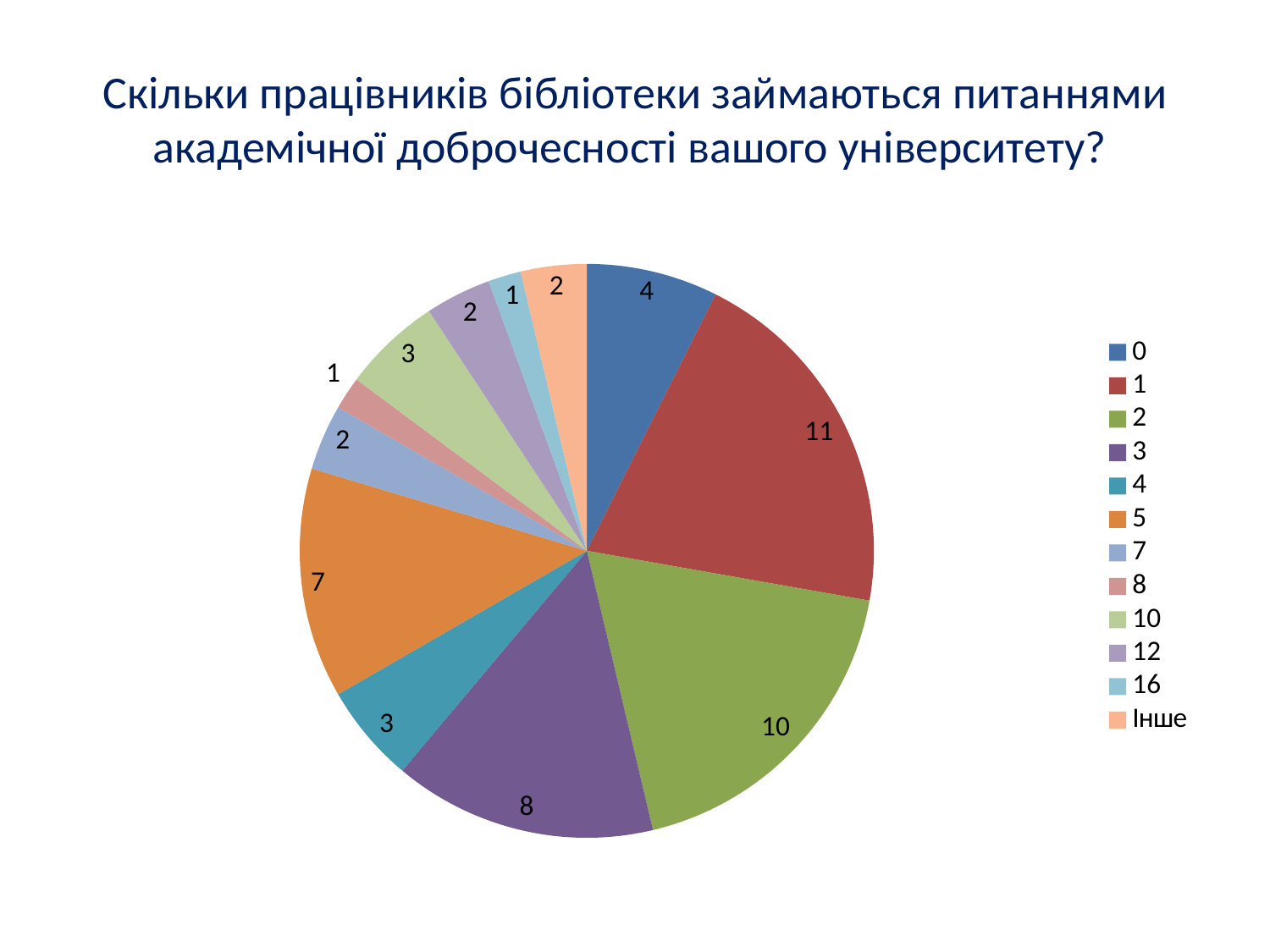
What is the title of the chart? Скільки працівників бібліотеки займаються питаннями академічної доброчесності вашого університету? What is the total of all the slice values in the pie? 54 What is the difference between the values for categories "3" and "4"? 5 Which is larger, the value for category "5" or the value for category "3"? 3 What is the value for the category "1"? 11 What is the value for the category "5"? 7 Which category has the largest slice of the pie? 1 What is the value for the category "Інше"? 2 How many categories does the legend list? 12 What is the difference between the values for categories "1" and "2"? 1 What is the value for the category "0"? 4 What kind of chart is shown on the slide? pie chart